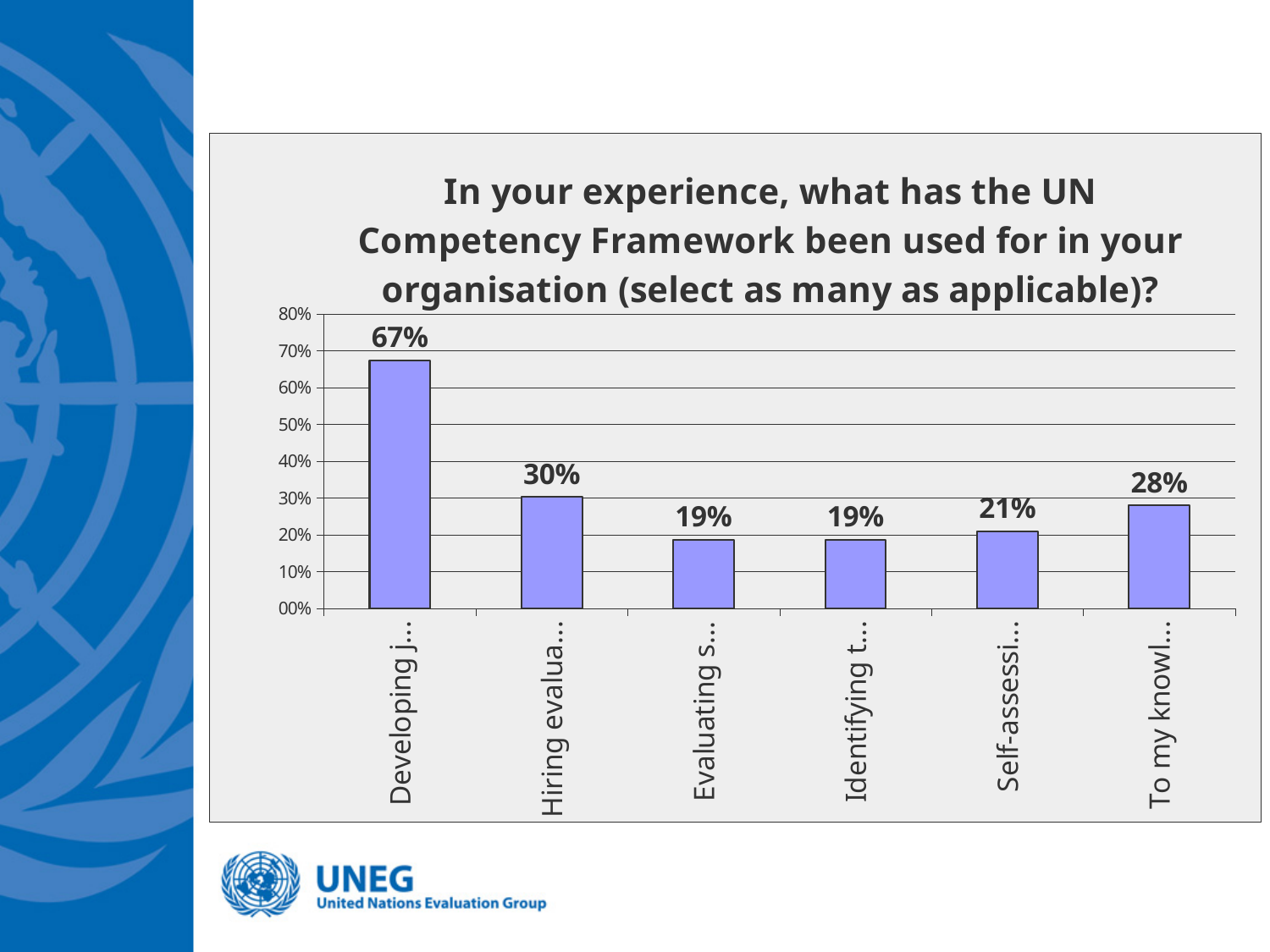
What is the value of the bar labelled "Self-assessi..."? 21% Which is larger, the value for "Hiring evalua..." or the value for "To my knowl..."? Hiring evalua... What is the value of the last bar, labelled "To my knowl..."? 28% How many bars share the value 19%? 2 What is the difference between the values for "To my knowl..." and "Self-assessi..."? 7% What is the value of the first bar, labelled "Developing j..."? 67% What kind of chart is shown on the slide? bar chart What is the difference between the values for "Developing j..." and "Hiring evalua..."? 37% How many bars are shown in the chart? 6 Is the value for "Developing j..." greater or less than 60%? greater Which category has the highest value? Developing j... What is the value of the bar labelled "Hiring evalua..."? 30%